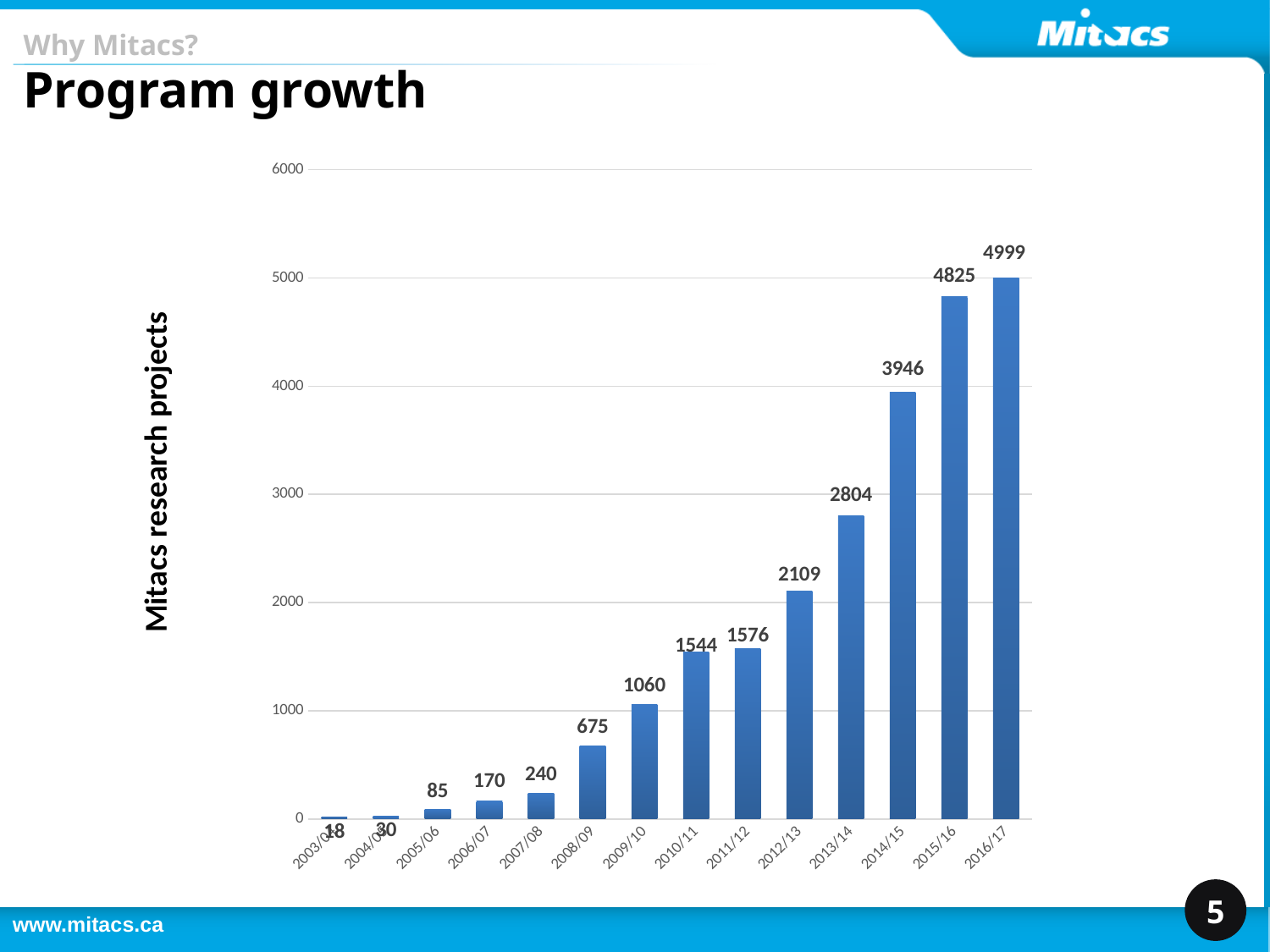
What is the value for 2014/15? 3946 Which year has the highest number of Mitacs research projects? 2016/17 What is the difference between the values for 2015/16 and 2014/15? 879 What is the value for 2012/13? 2109 What is the value for 2008/09? 675 How many Mitacs research projects were there in 2016/17? 4999 What kind of chart is shown on the slide? bar chart Do the values generally rise or fall from 2003/04 to 2016/17? rise What is the difference between the values for 2013/14 and 2012/13? 695 How many years (bars) are shown on the chart? 14 Which is larger, the value for 2010/11 or the value for 2009/10? 2010/11 Is the value for 2013/14 greater or less than 3000? less